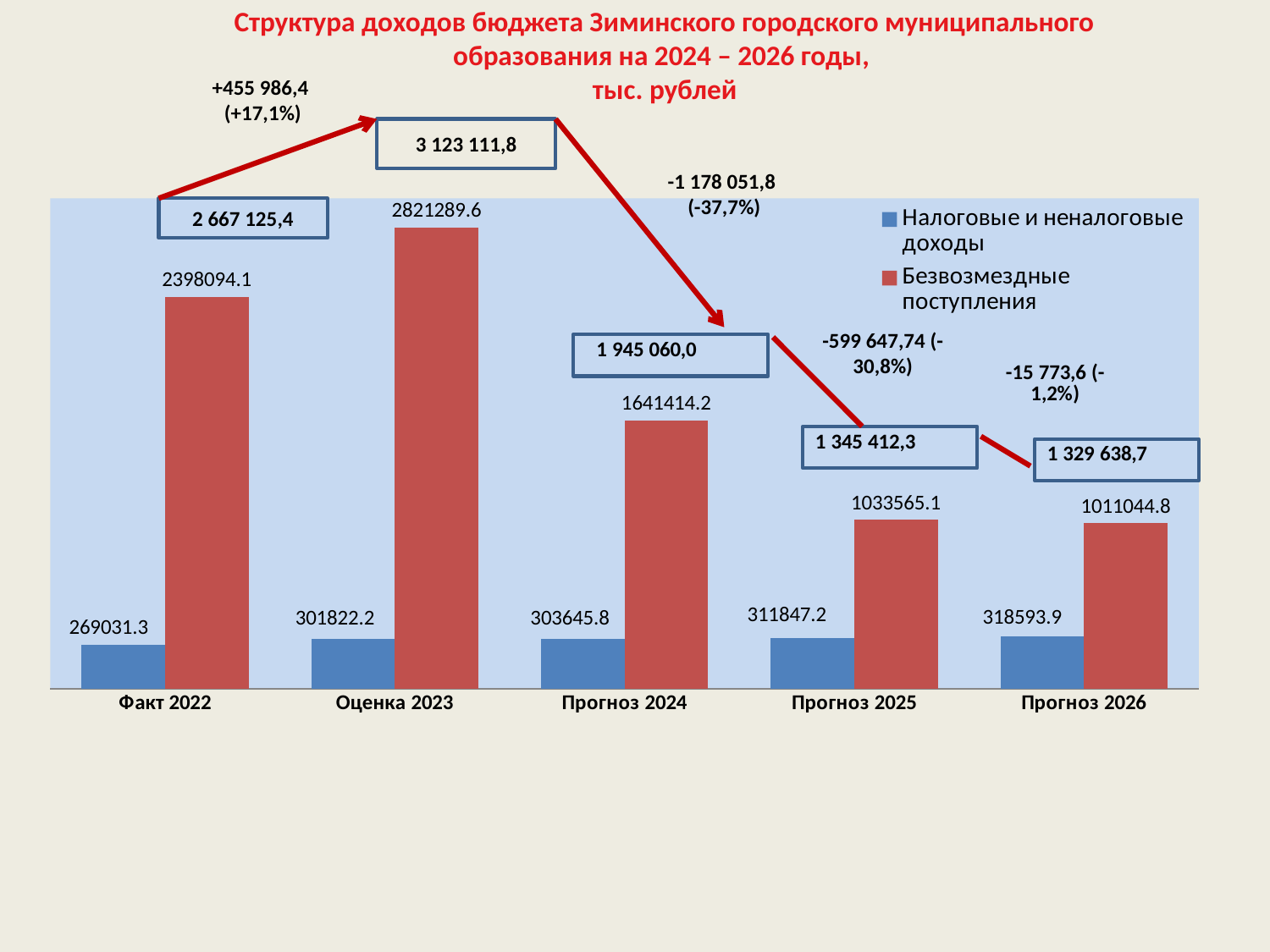
How many series does the legend list? 2 How many categories are shown on the x axis? 5 Which category has the highest value for Безвозмездные поступления? Оценка 2023 What kind of chart is shown on the slide? Bar chart Which category has the lowest value for Налоговые и неналоговые доходы? Факт 2022 Which is larger: Безвозмездные поступления for Прогноз 2025 or for Прогноз 2026? Прогноз 2025 What is the value of Налоговые и неналоговые доходы for Факт 2022? 269031.3 Do the values for Налоговые и неналоговые доходы rise or fall from Факт 2022 to Прогноз 2026? Rise What is the difference between Безвозмездные поступления for Оценка 2023 and Прогноз 2024? 1179875.4 What is the value of Налоговые и неналоговые доходы for Прогноз 2025? 311847.2 What is the value of Безвозмездные поступления for Прогноз 2026? 1011044.8 What is the value of Безвозмездные поступления for Оценка 2023? 2821289.6